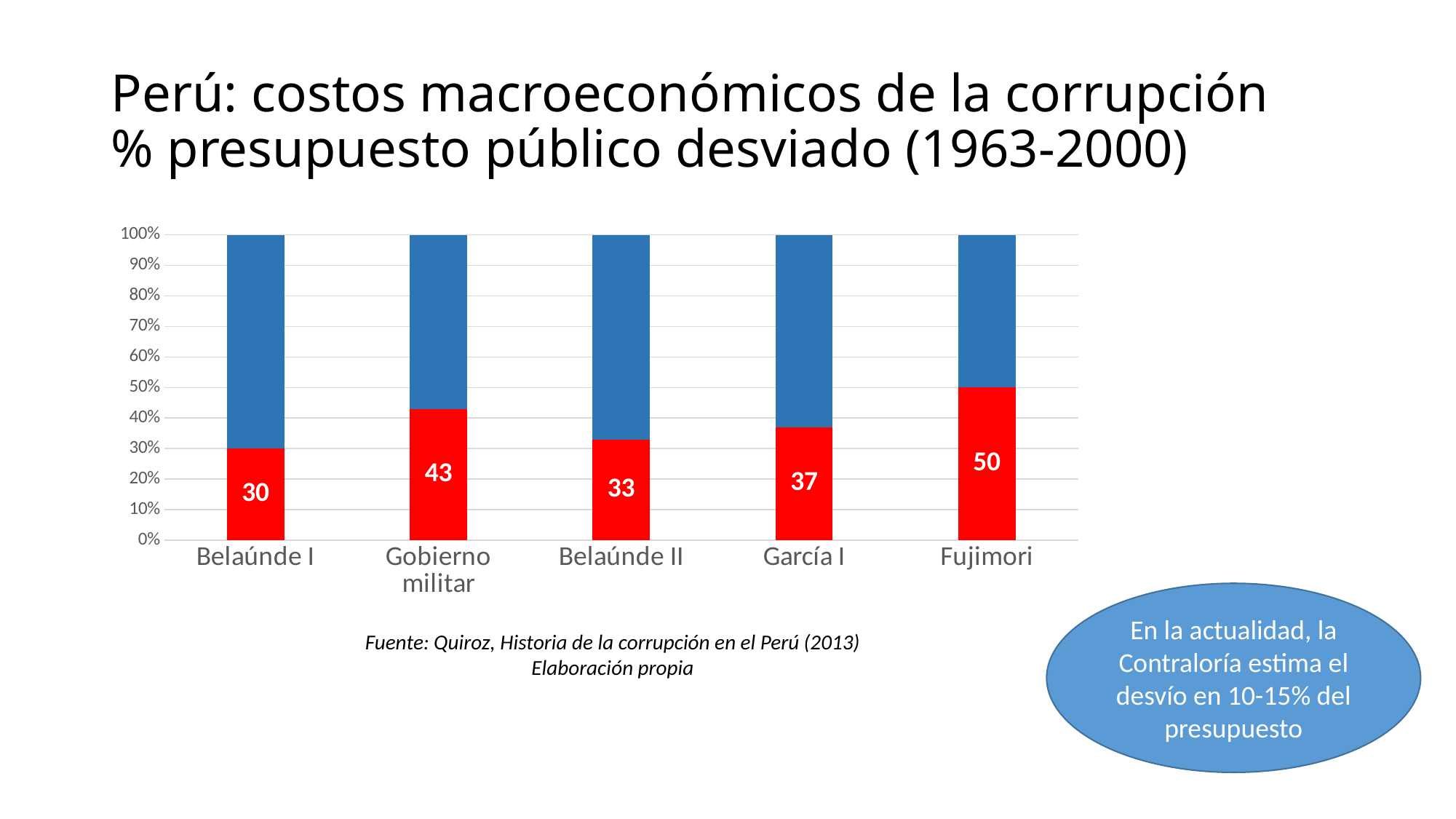
What is the red (diverted budget) value labelled for Belaúnde I? 30 Which has a larger red value, Belaúnde II or García I? García I What is the maximum value shown on the vertical axis? 100% What kind of chart is shown on the slide? Stacked bar chart How many governments (categories) are shown on the x axis? 5 What is the red value labelled for Fujimori? 50 Is the red value for Gobierno militar greater or less than 40%? greater What is the difference between the red values for Fujimori and Belaúnde I? 20 Which government has the highest red (diverted budget) value? Fujimori What is the red value labelled for Gobierno militar? 43 What is the difference between the red values for Gobierno militar and García I? 6 Which government has the lowest red (diverted budget) value? Belaúnde I